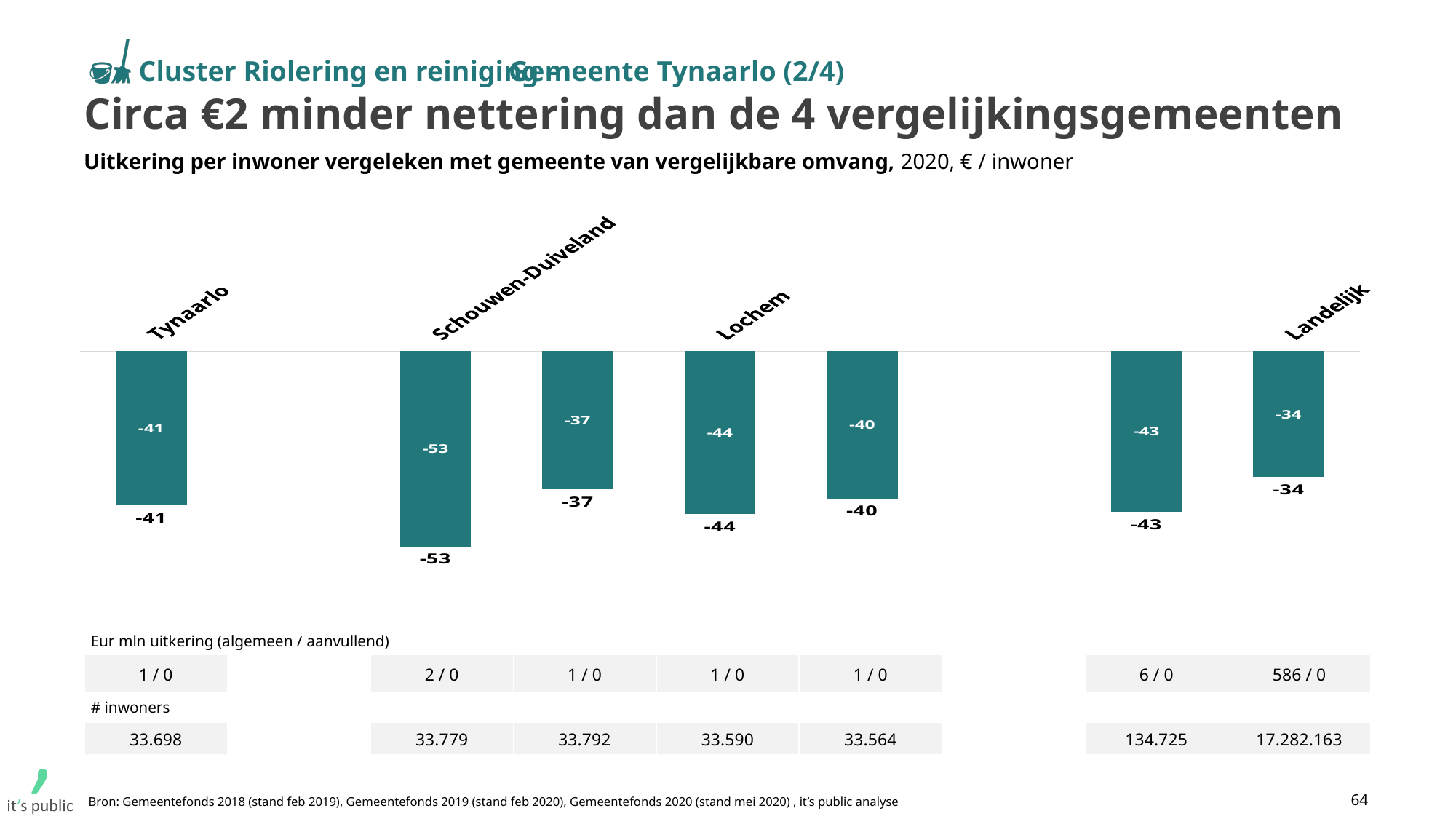
What is the difference between the values for Tynaarlo and Landelijk? 7 What is the value for Tynaarlo? -41 What kind of chart is shown on the slide? Bar chart Which category has the lowest (most negative) value? Schouwen-Duiveland What is the difference between the values for Schouwen-Duiveland and Lochem? 9 What is the value for Landelijk? -34 Which bar extends further below zero, Tynaarlo or Schouwen-Duiveland? Schouwen-Duiveland What is the value for Schouwen-Duiveland? -53 What is the value for Lochem? -44 In what unit are the chart values expressed, according to the chart subtitle? € / inwoner How many bars are plotted in the chart? 7 Which category has the highest (least negative) value? Landelijk